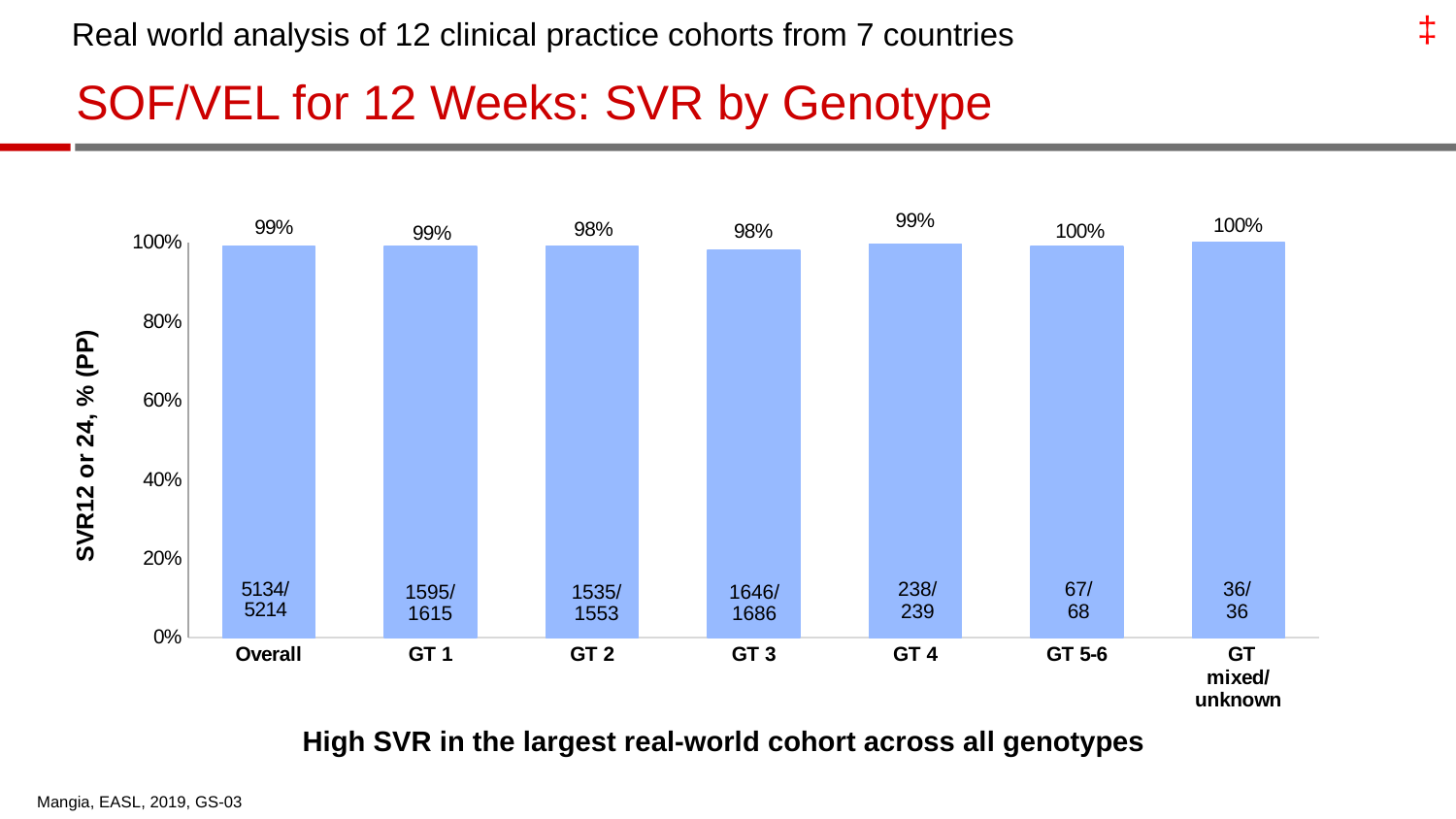
What is the SVR value for GT 5-6? 100% Which genotype categories have the lowest SVR value? GT 2 and GT 3 What kind of chart is shown on the slide? Bar chart What is the SVR value for GT 3? 98% What is the SVR value for the Overall group? 99% What fraction of patients is shown inside the Overall bar? 5134/5214 What is the label of the y axis? SVR12 or 24, % (PP) What fraction of patients is shown inside the GT 4 bar? 238/239 How many genotype categories are shown on the x axis? 7 Is the SVR value for GT 1 greater or less than 80%? greater What is the title of the chart on the slide? SOF/VEL for 12 Weeks: SVR by Genotype What is the difference between the SVR value for GT 5-6 and the SVR value for GT 2? 2%